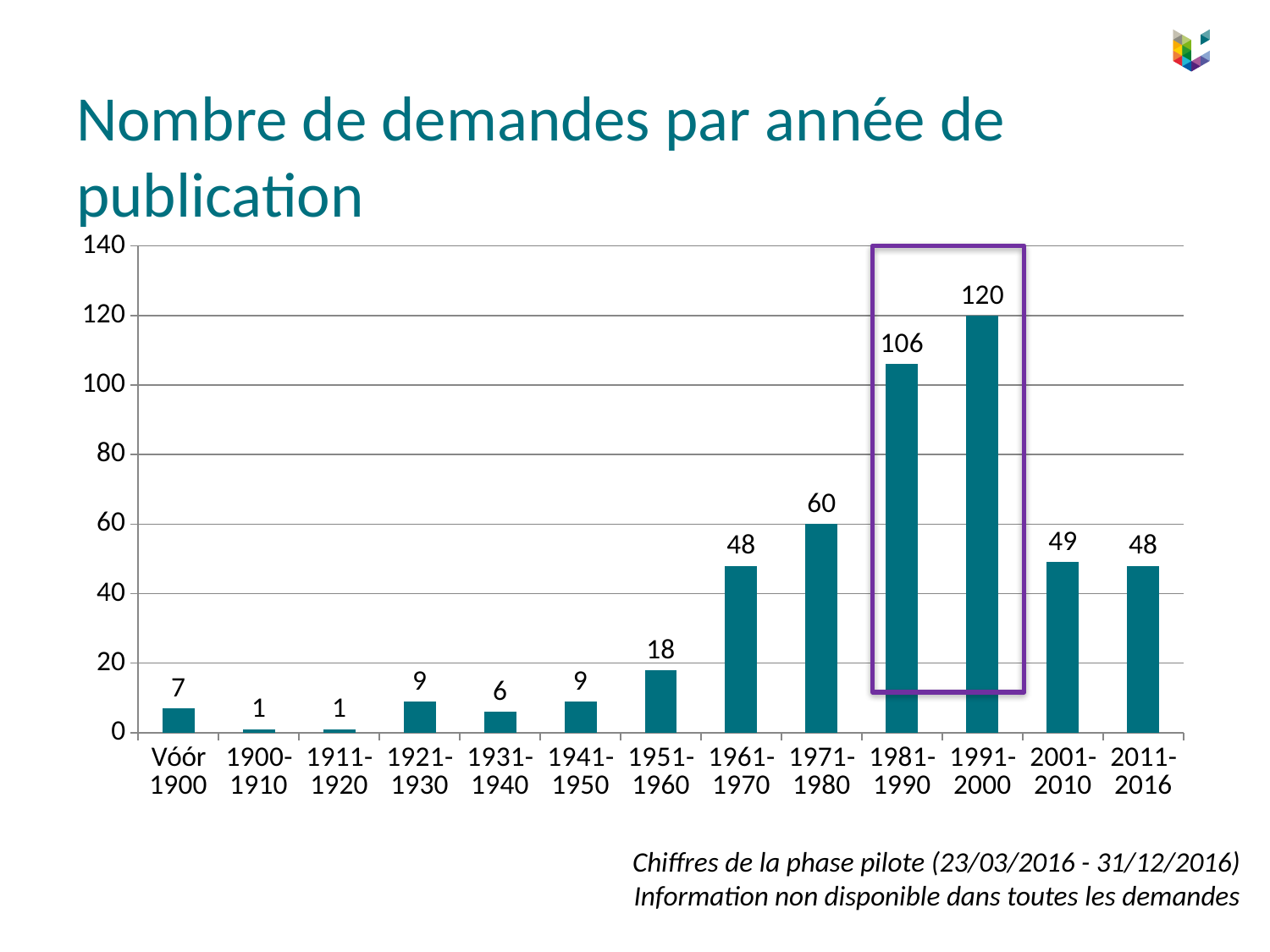
What is the value for 1991-2000? 120 Do the values rise or fall from 1951-1960 to 1991-2000? rise Is the value for 1981-1990 greater or less than 100? greater What is the value for 1951-1960? 18 What kind of chart is shown on the slide? bar chart What is the difference between the values for 1991-2000 and 1981-1990? 14 How many categories are shown on the x axis? 13 What is the title of the chart? Nombre de demandes par année de publication Which two categories are enclosed by the purple rectangle? 1981-1990 and 1991-2000 Which is larger, the value for 1971-1980 or the value for 2001-2010? 1971-1980 What is the value for Vóór 1900? 7 Which category has the highest value? 1991-2000